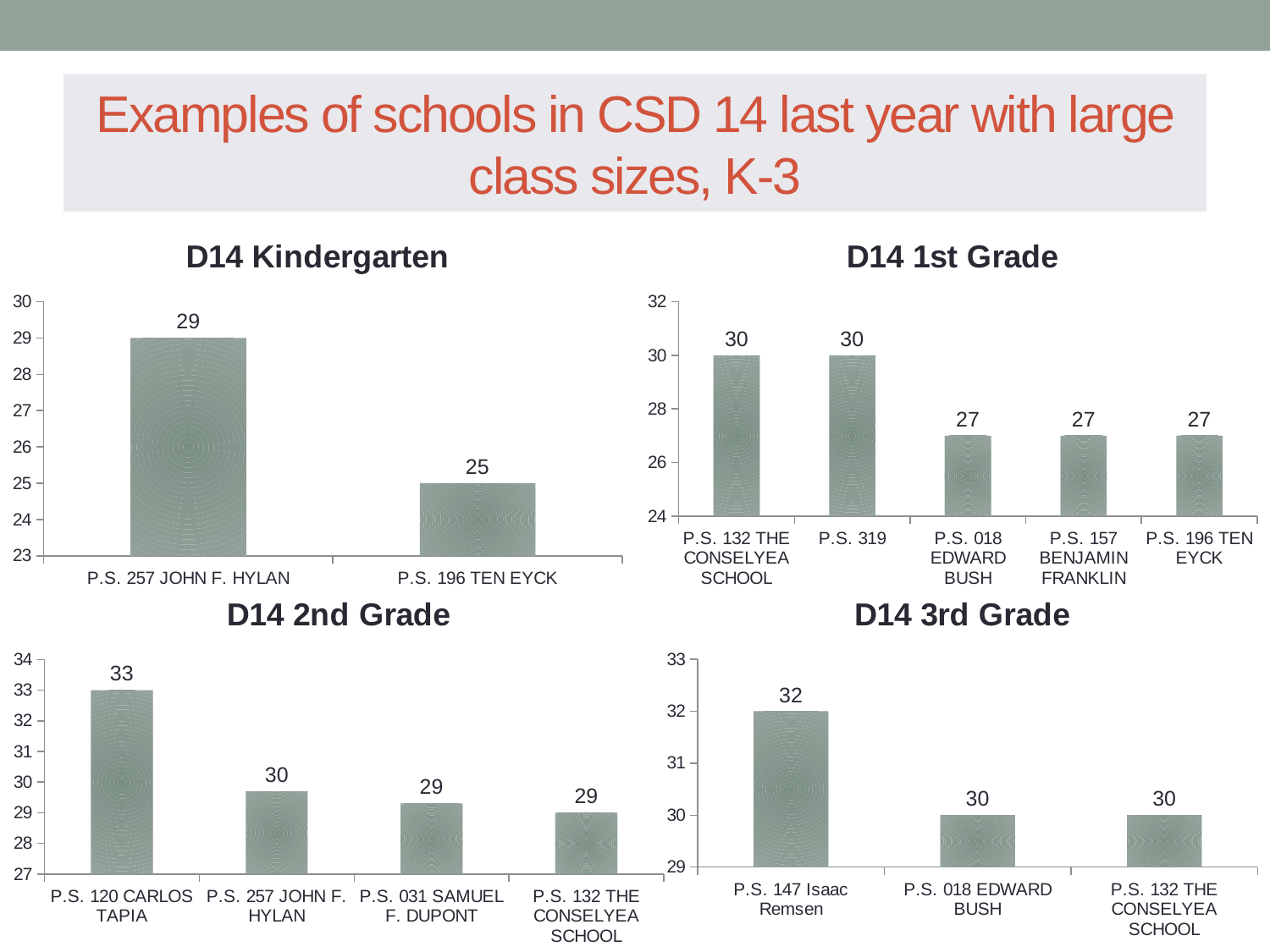
In the D14 1st Grade chart, how many schools are shown? 5 In the D14 3rd Grade chart, what is the difference between P.S. 147 Isaac Remsen and P.S. 018 EDWARD BUSH? 2 In the D14 2nd Grade chart, do the values rise or fall from left to right? fall In the D14 Kindergarten chart, what is the class size for P.S. 257 JOHN F. HYLAN? 29 What type of chart is the D14 3rd Grade chart? bar chart In the D14 1st Grade chart, what is the difference between P.S. 319 and P.S. 196 TEN EYCK? 3 In the D14 Kindergarten chart, which is larger, P.S. 257 JOHN F. HYLAN or P.S. 196 TEN EYCK? P.S. 257 JOHN F. HYLAN In the D14 3rd Grade chart, which school has the highest value? P.S. 147 Isaac Remsen In the D14 Kindergarten chart, what is the difference between P.S. 257 JOHN F. HYLAN and P.S. 196 TEN EYCK? 4 In the D14 2nd Grade chart, which school has the largest class size? P.S. 120 CARLOS TAPIA In the D14 2nd Grade chart, what is the value for P.S. 031 SAMUEL F. DUPONT? 29 In the D14 1st Grade chart, what is the value for P.S. 018 EDWARD BUSH? 27